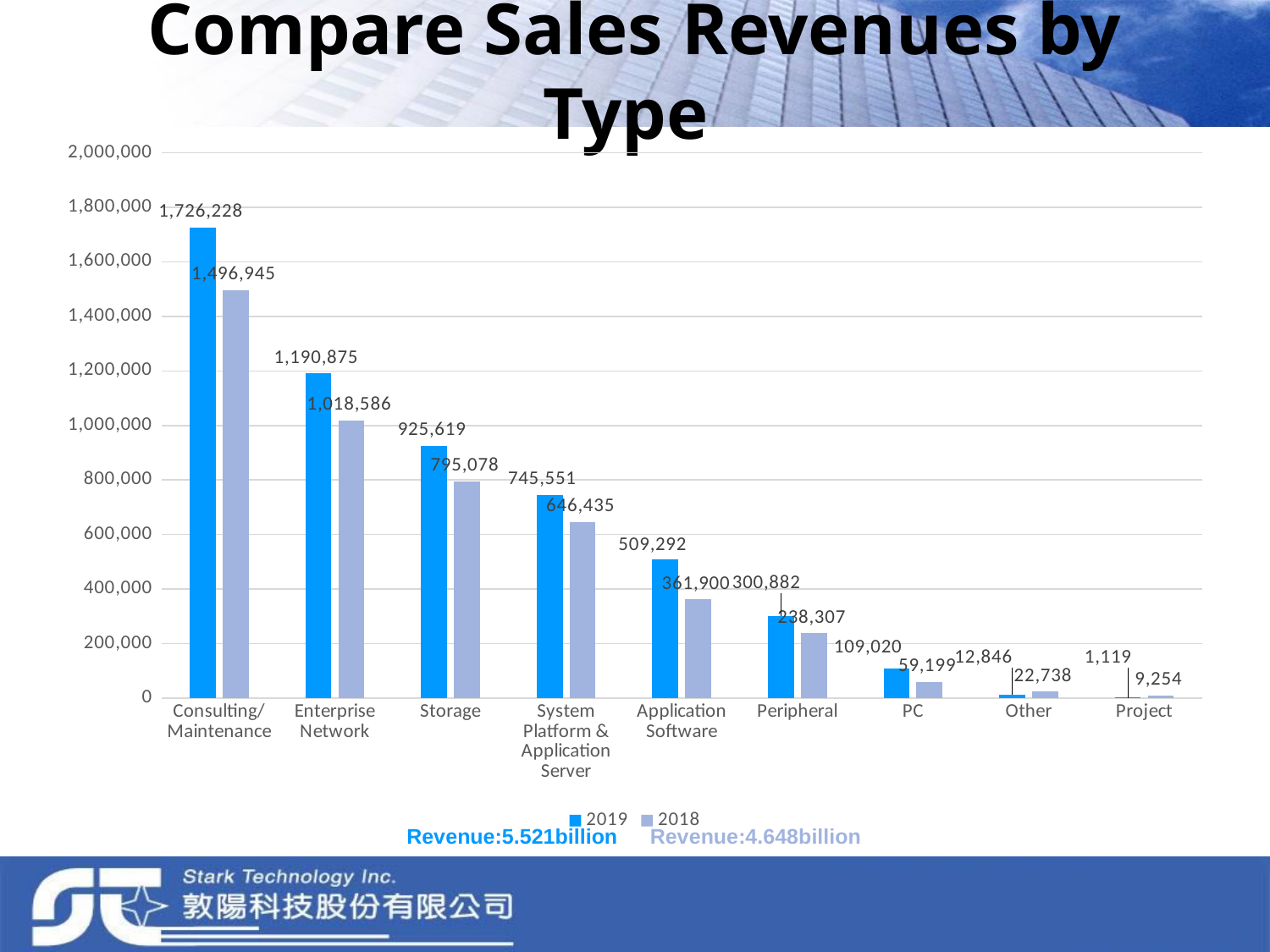
How many categories are shown on the x axis? 9 What is the 2018 value for Enterprise Network? 1,018,586 What is the difference between the 2019 and 2018 values for Consulting/Maintenance? 229,283 Do the 2019 values rise or fall moving from Consulting/Maintenance to Project along the x axis? Fall Which category has the lowest 2019 value? Project What is the difference between the 2019 and 2018 values for PC? 49,821 How many series does the legend list? 2 Which category has the highest 2019 value? Consulting/Maintenance For Other, which is larger: the 2019 value or the 2018 value? 2018 What is the 2019 value for Storage? 925,619 What type of chart is shown on the slide? Bar chart What is the 2019 value for PC? 109,020